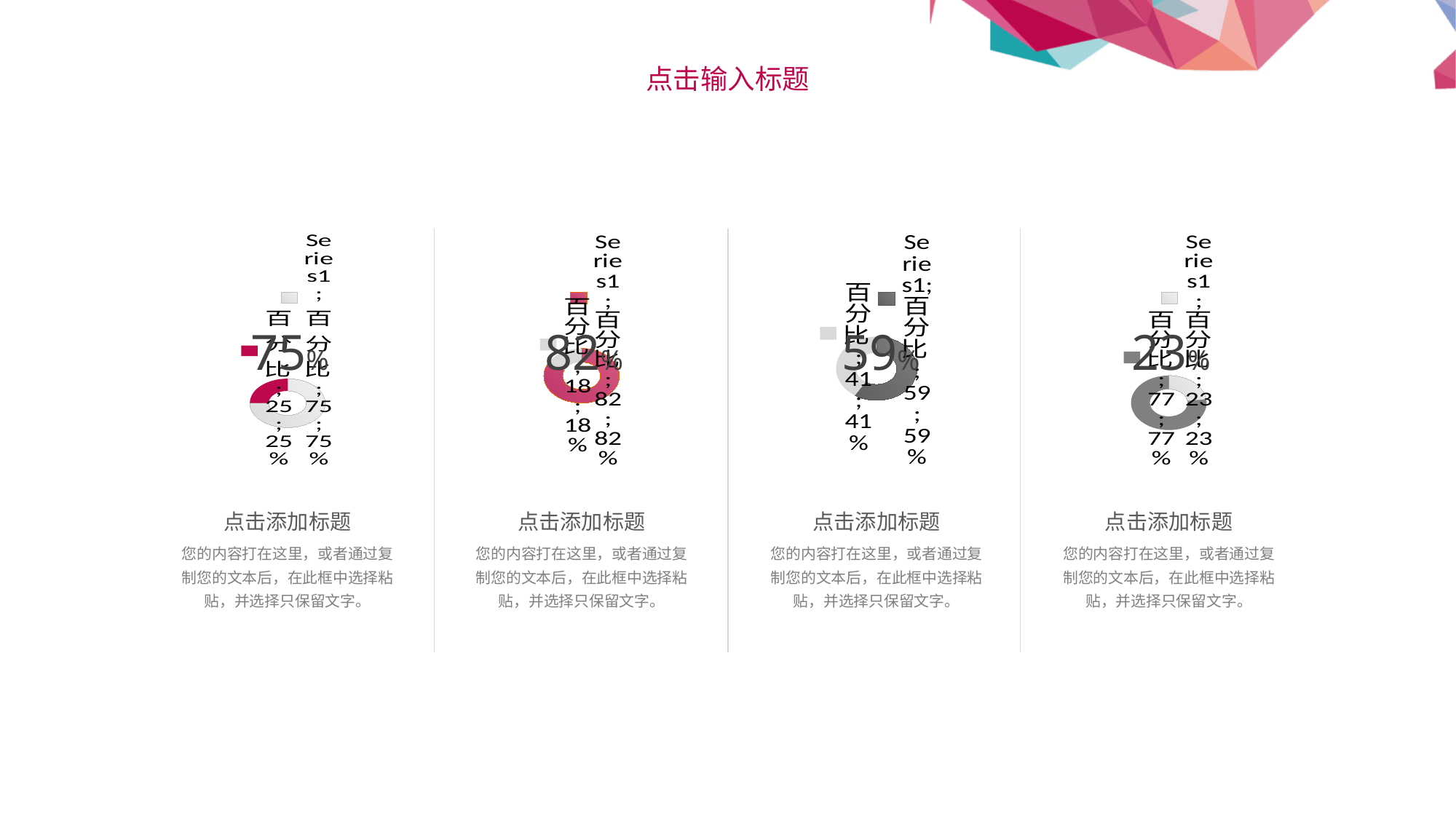
What large percentage is displayed on the second chart from the left? 82% What large percentage is displayed on the leftmost chart? 75% Which of the four charts displays the highest percentage? the second chart (82%) What kind of chart is used in each of the four panels on the slide? doughnut chart In the second chart from the left, what share does the smaller slice have according to its data label? 18% Is the percentage on the leftmost chart (75%) larger or smaller than the percentage on the third chart (59%)? larger What is the difference between the percentage on the second chart (82%) and the percentage on the leftmost chart (75%)? 7 percentage points What large percentage is displayed on the rightmost chart? 23% How many doughnut charts are on the slide? 4 Which of the four charts displays the lowest percentage? the rightmost chart (23%) What series name appears in the legend of each chart? Series1 What large percentage is displayed on the third chart from the left? 59%